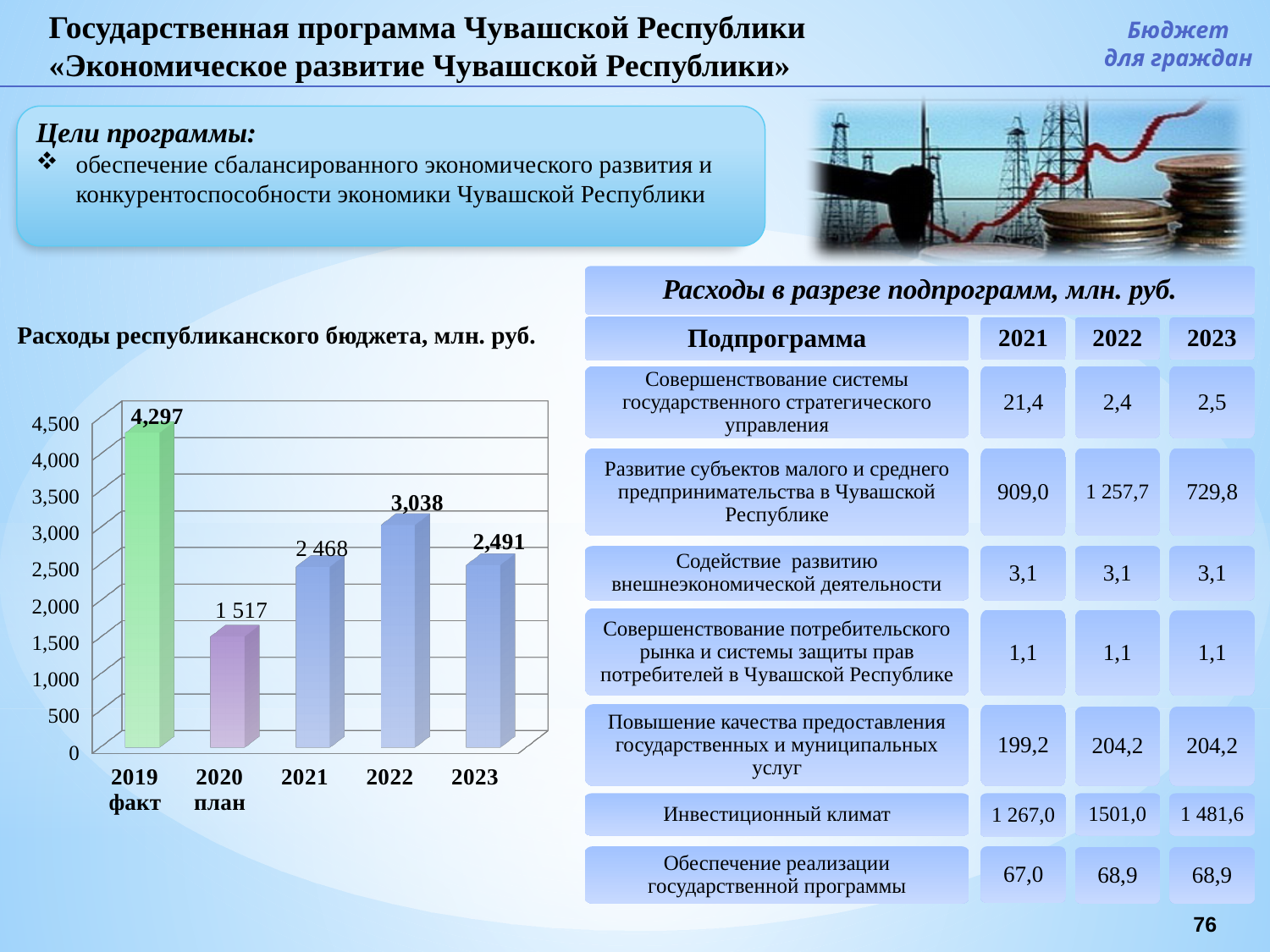
What is the value for 2023 in the bar chart? 2,491 What is the value for 2020 план in the bar chart? 1 517 What kind of chart is shown on the slide? bar chart Which category has the highest value in the bar chart? 2019 факт What is the value for 2019 факт in the bar chart? 4,297 What is the difference between the values for 2019 факт and 2020 план in the bar chart? 2,780 Which category has the lowest value in the bar chart? 2020 план How many categories are shown in the bar chart? 5 What is the difference between the values for 2022 and 2023 in the bar chart? 547 Do the values in the bar chart rise or fall from 2020 план to 2022? rise What is the value for 2022 in the bar chart? 3,038 Which is larger in the bar chart, the value for 2021 or the value for 2023? 2023